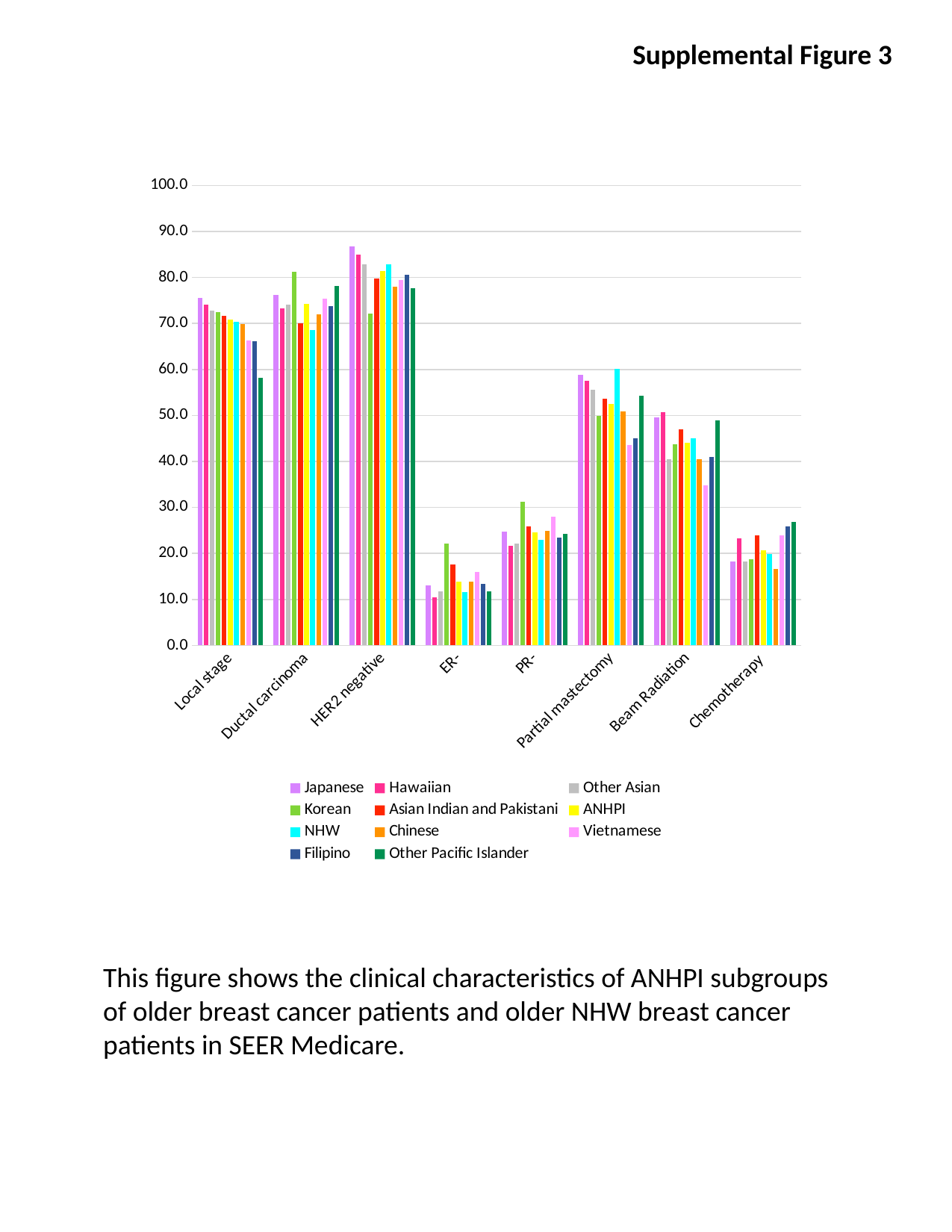
In the Ductal carcinoma category, which is larger: the value for Korean or the value for Japanese? Korean Is the value for Other Pacific Islander in the Local stage category greater or less than 60? less Which series has the highest value in the PR- category? Korean Is the value for Japanese in the HER2 negative category greater or less than 80? greater Is the value for Chinese in the Chemotherapy category greater or less than 20? less How many series does the chart's legend list? 11 Which series has the lowest value in the Local stage category? Other Pacific Islander How many categories are shown along the x axis of the chart? 8 Which series has the highest value in the HER2 negative category? Japanese Which legend entry is shown in dark green? Other Pacific Islander What kind of chart is shown on the slide? bar chart